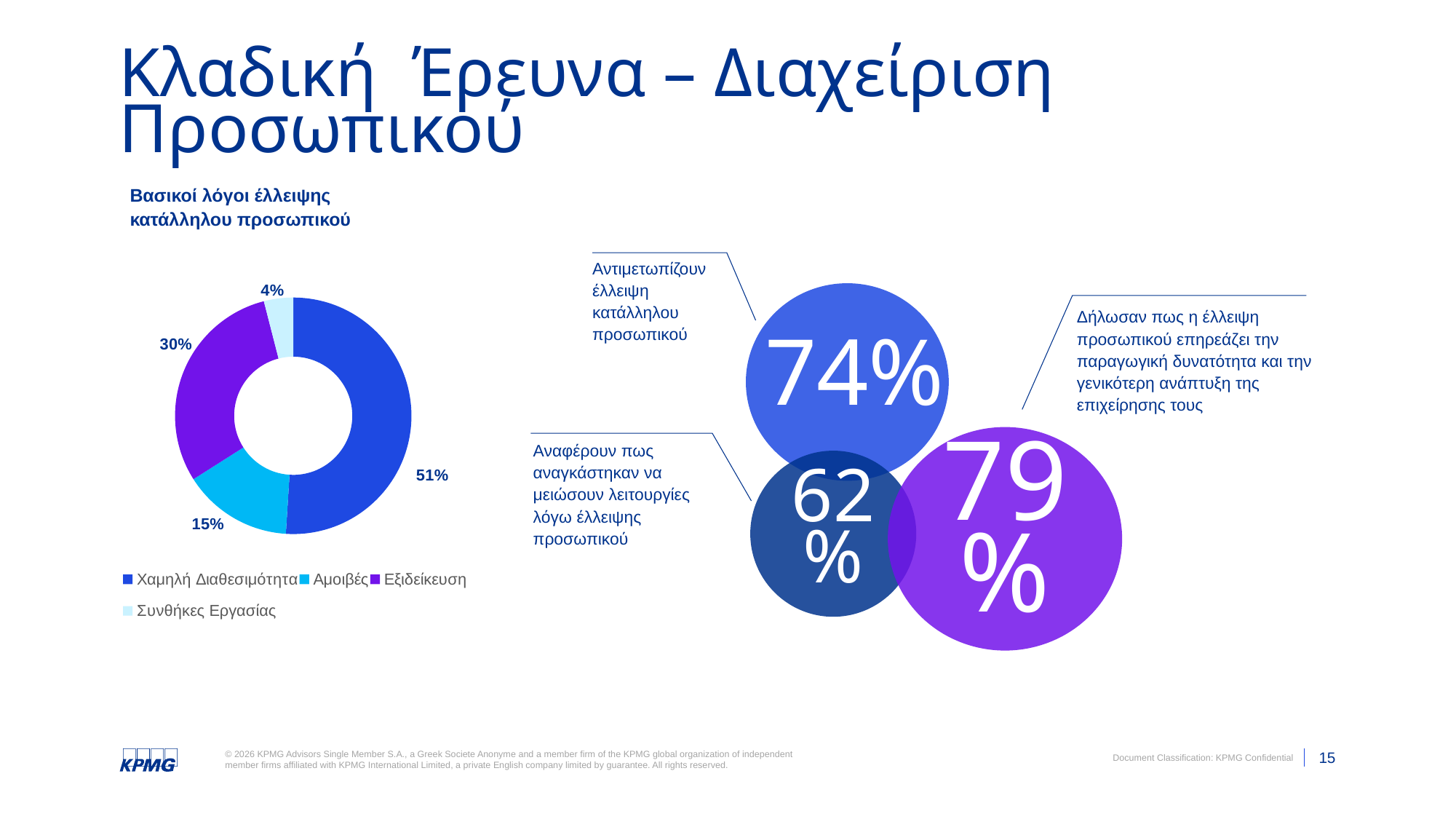
What is the title of the doughnut chart? Βασικοί λόγοι έλλειψης κατάλληλου προσωπικού In the doughnut chart, what percentage is shown for Συνθήκες Εργασίας? 4% How many categories does the doughnut chart show? 4 In the doughnut chart, what is the difference in percentage points between Χαμηλή Διαθεσιμότητα and Εξιδείκευση? 21 percentage points In the doughnut chart, which is larger: Αμοιβές or Εξιδείκευση? Εξιδείκευση Which category in the doughnut chart is shown in light blue (the lightest colour)? Συνθήκες Εργασίας Which category has the largest share in the doughnut chart? Χαμηλή Διαθεσιμότητα In the doughnut chart, what percentage is shown for Εξιδείκευση? 30% What kind of chart is shown under the heading "Βασικοί λόγοι έλλειψης κατάλληλου προσωπικού"? Doughnut (pie) chart In the doughnut chart, what percentage is shown for Χαμηλή Διαθεσιμότητα? 51% Which category has the smallest share in the doughnut chart? Συνθήκες Εργασίας In the doughnut chart, what percentage is shown for Αμοιβές? 15%